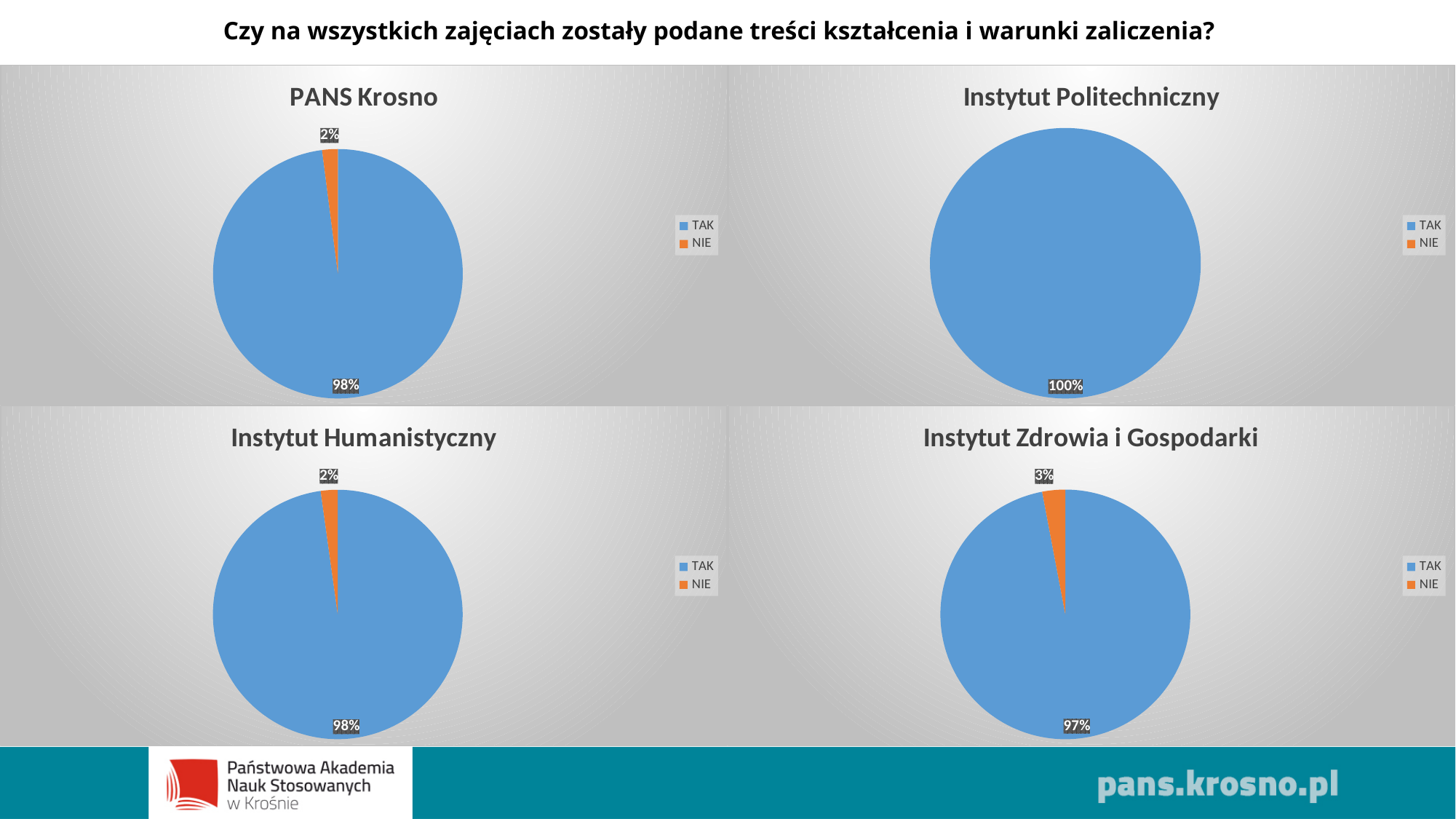
In the "Instytut Humanistyczny" chart, what colour is the TAK slice? Blue In the "Instytut Zdrowia i Gospodarki" chart, what is the difference between the TAK and NIE percentages? 94% How many entries does the legend of the "Instytut Politechniczny" chart list? 2 In the "Instytut Zdrowia i Gospodarki" chart, what percentage is shown for TAK? 97% In the "Instytut Zdrowia i Gospodarki" chart, which slice is the largest? TAK In the "Instytut Humanistyczny" chart, what percentage is shown for NIE? 2% In the "Instytut Zdrowia i Gospodarki" chart, what percentage is shown for NIE? 3% In the "PANS Krosno" chart, what percentage is shown for NIE? 2% In the "Instytut Humanistyczny" chart, which slice is the smallest? NIE What type of chart is the "PANS Krosno" chart? Pie chart In the "PANS Krosno" chart, what percentage is shown for TAK? 98% In the "Instytut Politechniczny" chart, what percentage is shown for TAK? 100%